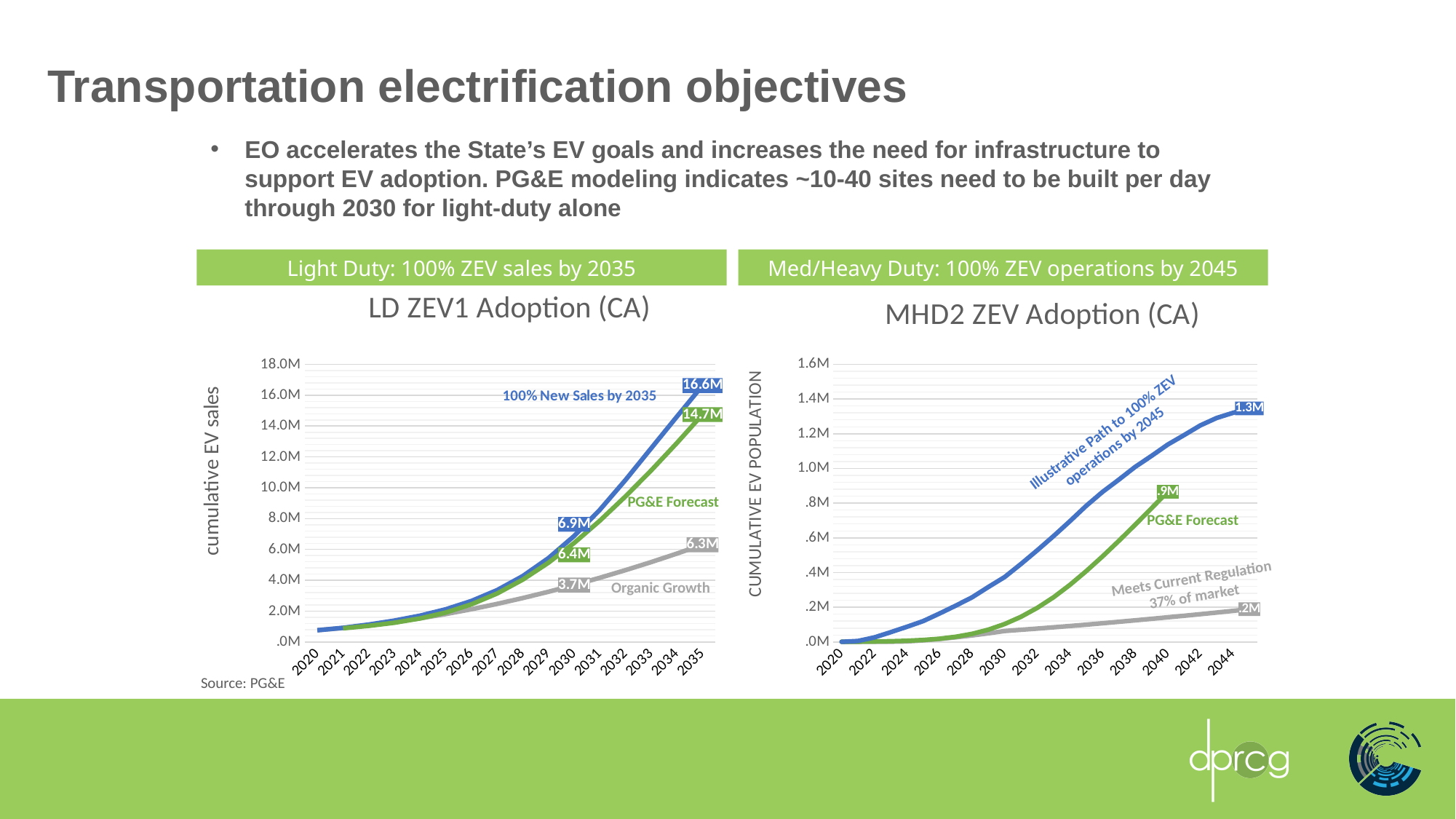
In the MHD2 ZEV Adoption (CA) chart, does the PG&E Forecast line rise or fall from 2020 to 2040? rises What kind of chart is the LD ZEV1 Adoption (CA) chart? Line chart In the LD ZEV1 Adoption (CA) chart, is the 100% New Sales by 2035 value in 2025 greater or less than 4.0M? less In the LD ZEV1 Adoption (CA) chart, what is the PG&E Forecast value in 2030? 6.4M In the LD ZEV1 Adoption (CA) chart, which series has the highest value in 2035? 100% New Sales by 2035 In the MHD2 ZEV Adoption (CA) chart, which series has the lowest value in 2044? Meets Current Regulation 37% of market In the LD ZEV1 Adoption (CA) chart, what is the Organic Growth value in 2035? 6.3M In the LD ZEV1 Adoption (CA) chart, what is the difference between the 100% New Sales by 2035 value and the PG&E Forecast value in 2035? 1.9M In the MHD2 ZEV Adoption (CA) chart, what is the value of the Illustrative Path to 100% ZEV operations by 2045 series in 2044? 1.3M In the MHD2 ZEV Adoption (CA) chart, what value is labeled at the end of the PG&E Forecast line? .9M In the LD ZEV1 Adoption (CA) chart, what is the value of the 100% New Sales by 2035 series in 2035? 16.6M In the MHD2 ZEV Adoption (CA) chart, what is the value of the Meets Current Regulation 37% of market series in 2044? .2M